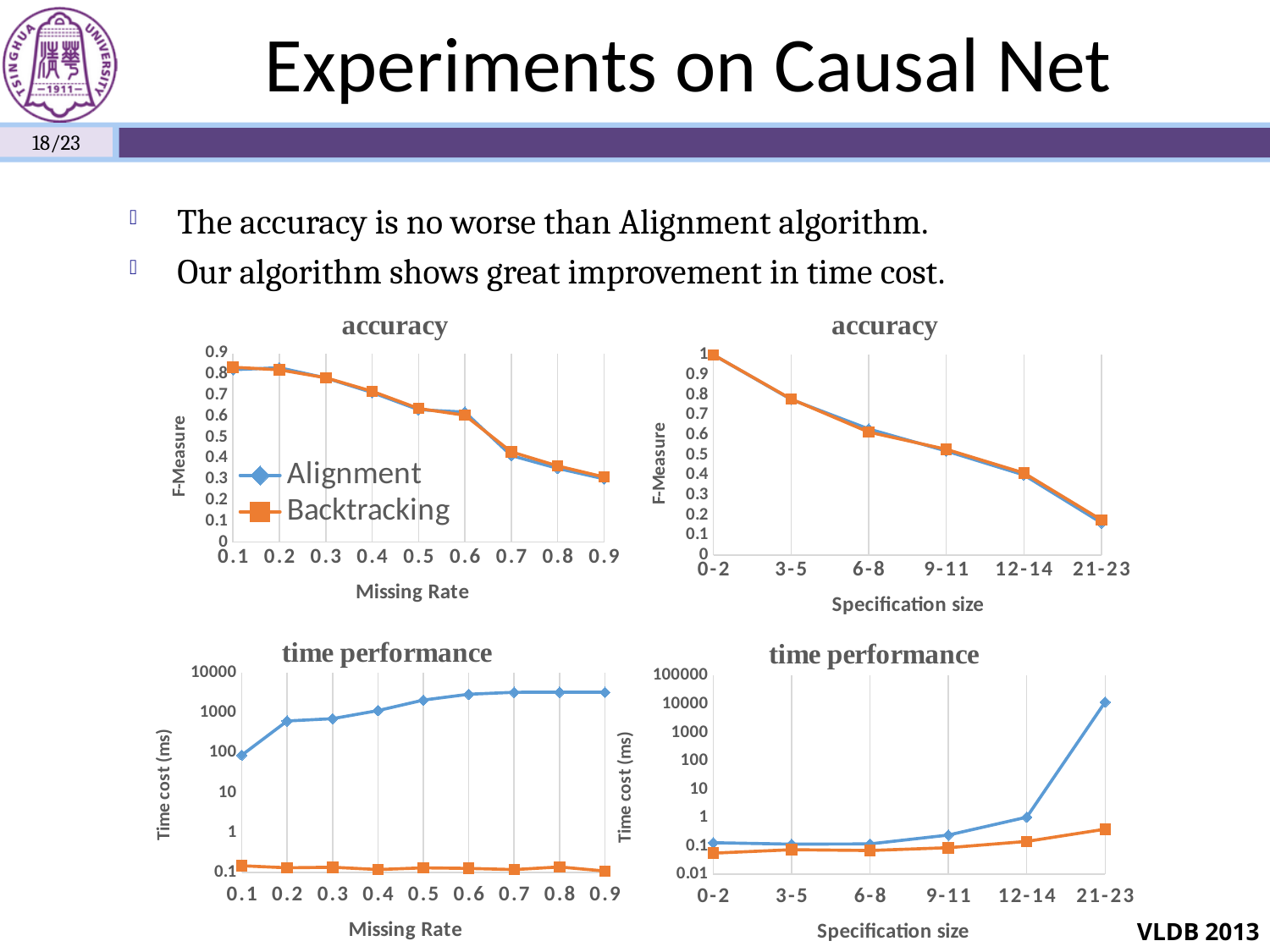
In the top-right 'accuracy' chart, how many specification size categories are on the x axis? 6 In the bottom-left 'time performance' chart, does the Alignment time cost rise or fall as the missing rate increases? rise What kind of chart is the top-left 'accuracy' chart? line chart In the top-left 'accuracy' chart, at which missing rate is the F-Measure lowest? 0.9 In the bottom-right 'time performance' chart, is the Alignment time cost at specification size 21-23 greater or less than 1000? greater In the top-left 'accuracy' chart, how many series does the legend list? 2 In the top-right 'accuracy' chart, is the F-Measure at specification size 21-23 greater or less than 0.5? less In the top-left 'accuracy' chart, how many missing rate values are plotted along the x axis? 9 In the bottom-left 'time performance' chart, is the Alignment time cost at missing rate 0.9 greater or less than 1000? greater In the bottom-left 'time performance' chart, at missing rate 0.5, which series has the larger time cost, Alignment or Backtracking? Alignment In the top-left 'accuracy' chart, does the F-Measure rise or fall as the missing rate increases? fall In the top-right 'accuracy' chart, which specification size has the highest F-Measure? 0-2